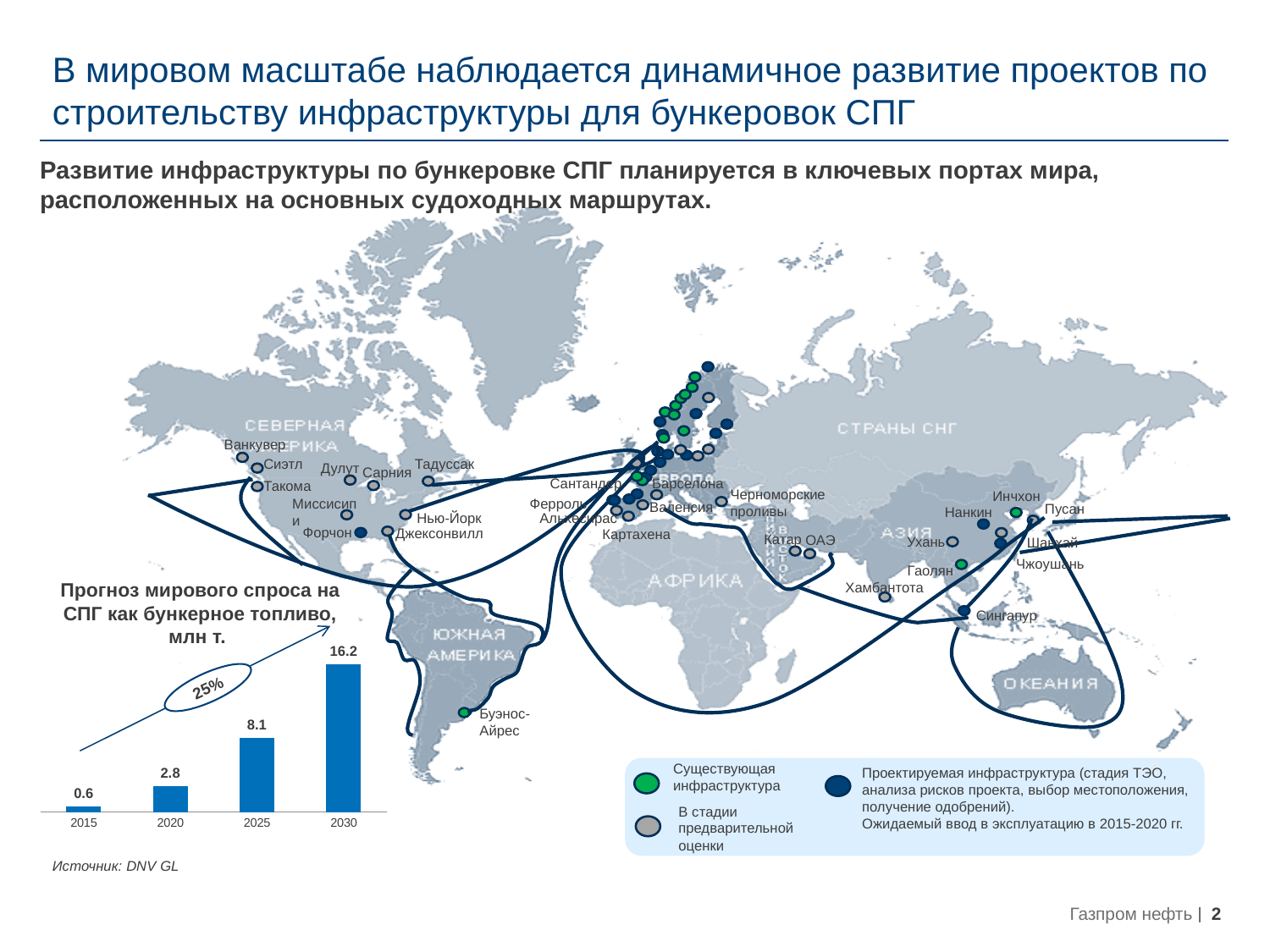
What kind of chart is used to show the forecast of global LNG bunker fuel demand? bar chart How many years are shown in the bar chart? 4 Which year has the lowest value in the bar chart? 2015 What is the forecast value for 2020 in the bar chart? 2.8 Which year has the highest value in the bar chart? 2030 What is the difference between the 2030 and 2025 values in the bar chart? 8.1 What is the forecast value for 2025 in the bar chart? 8.1 What is the forecast value for 2015 in the bar chart? 0.6 What is the difference between the 2020 and 2015 values in the bar chart? 2.2 Do the values in the bar chart rise or fall from 2015 to 2030? rise Which is larger in the bar chart, the value for 2025 or the value for 2020? 2025 What is the forecast value for 2030 in the bar chart? 16.2